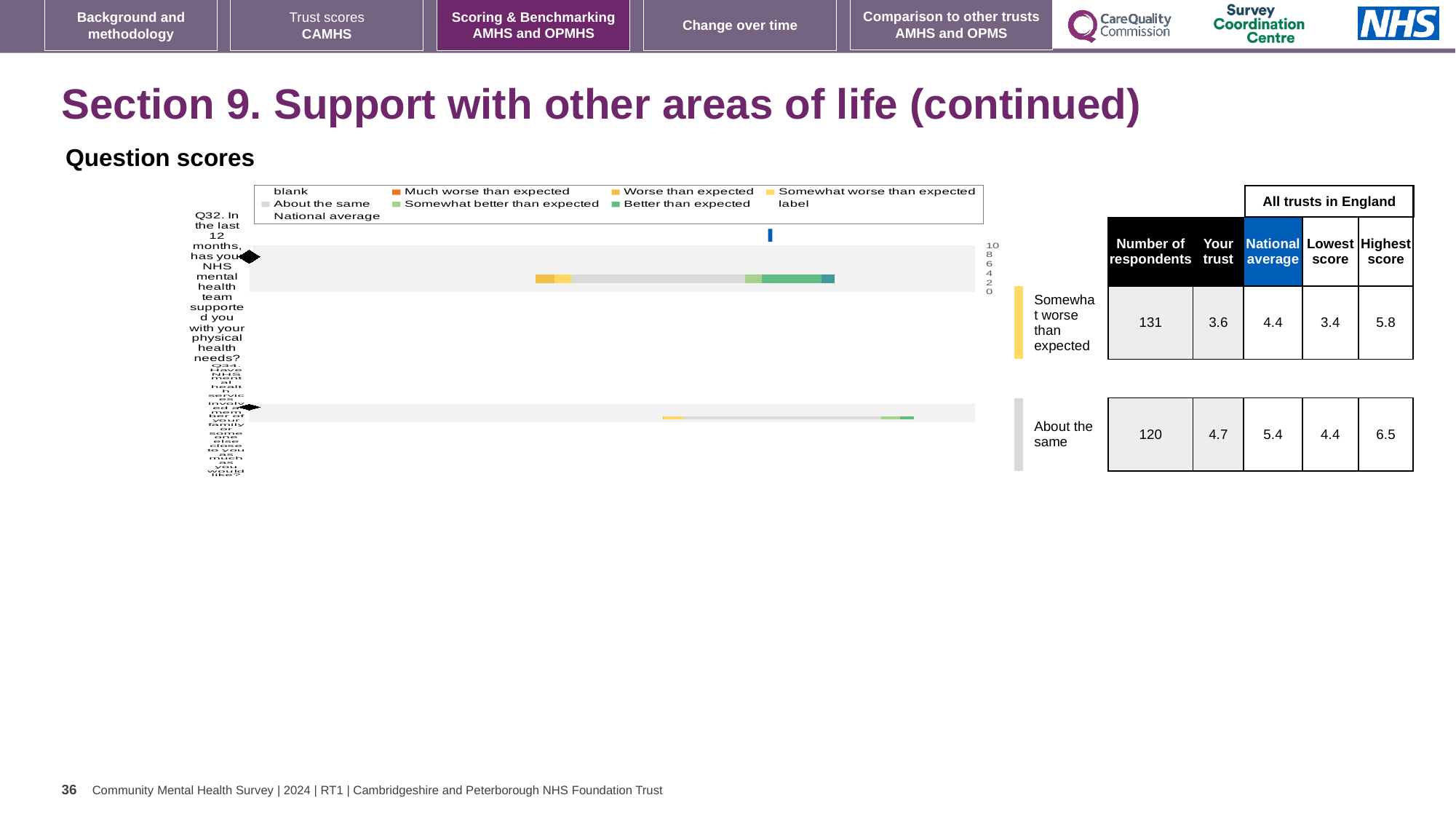
What is the national average score for Q34 (involving family or someone close)? 5.4 Which benchmark category is the trust's score for Q34 placed in? About the same What kind of chart is used to show the question scores on this slide? bar chart Which benchmark category is the trust's score for Q32 placed in? Somewhat worse than expected Which question has the higher 'Your trust' score, Q32 or Q34? Q34 What is the 'Your trust' score for Q32 (support with physical health needs)? 3.6 What is the difference between the national average and the trust's score for Q32? 0.8 How many respondents answered Q32? 131 What is the highest score across all trusts in England for Q34? 6.5 What colour does the legend use for 'Much worse than expected'? orange What is the difference between the highest and lowest trust scores for Q34? 2.1 How many questions are plotted in the question scores chart? 2